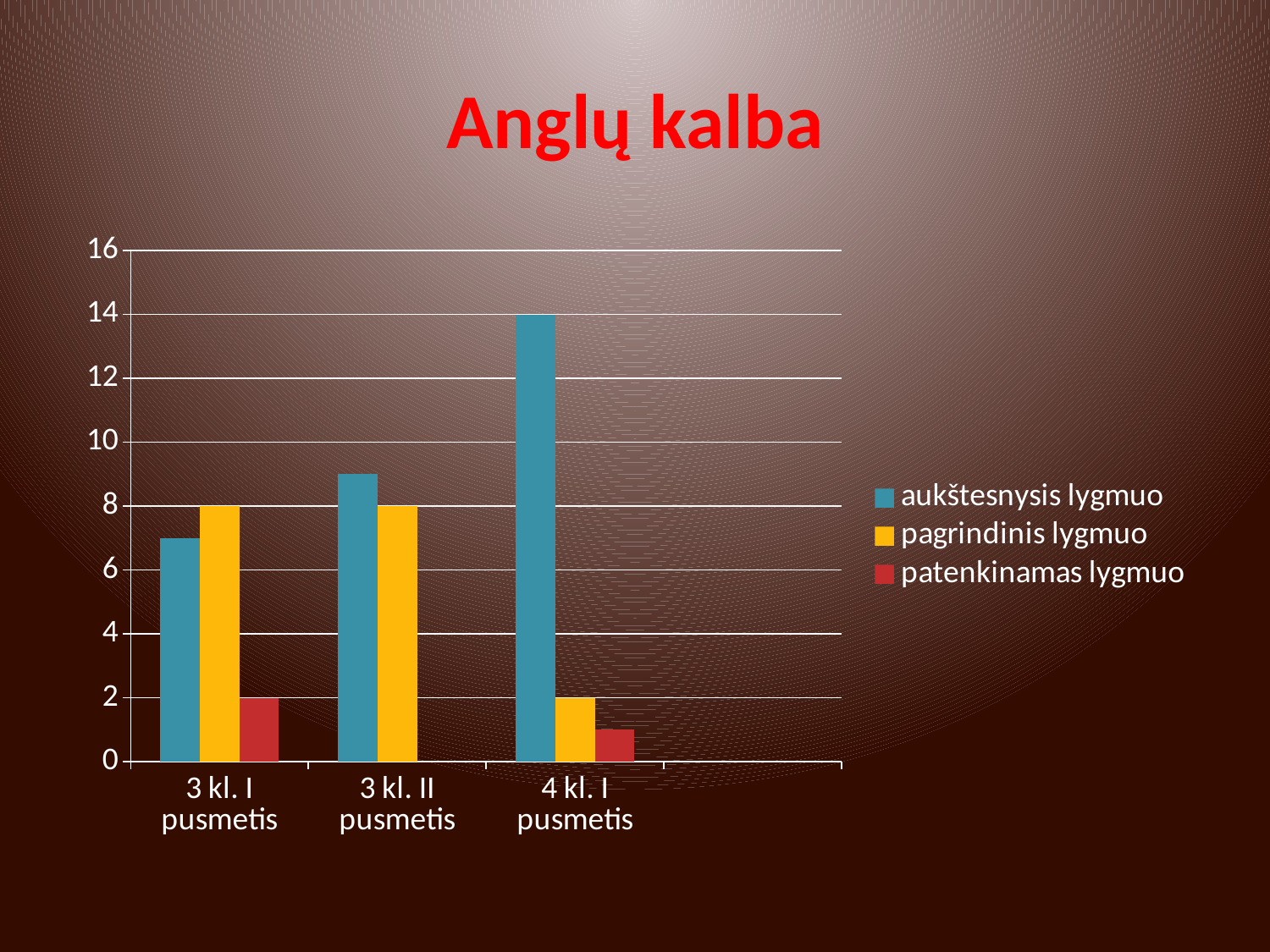
What is the difference between aukštesnysis lygmuo and pagrindinis lygmuo for 4 kl. I pusmetis? 12 What is the title of the chart? Anglų kalba What type of chart is shown on the slide? bar chart What is the value of pagrindinis lygmuo for 3 kl. I pusmetis? 8 What is the value of aukštesnysis lygmuo for 4 kl. I pusmetis? 14 How many series does the legend list? 3 Is the value of aukštesnysis lygmuo for 3 kl. II pusmetis greater or less than 8? greater How many categories are shown on the x axis? 3 What is the value of patenkinamas lygmuo for 3 kl. I pusmetis? 2 What is the value of pagrindinis lygmuo for 4 kl. I pusmetis? 2 For which category is aukštesnysis lygmuo highest? 4 kl. I pusmetis Is the value of aukštesnysis lygmuo for 3 kl. I pusmetis greater or less than 8? less